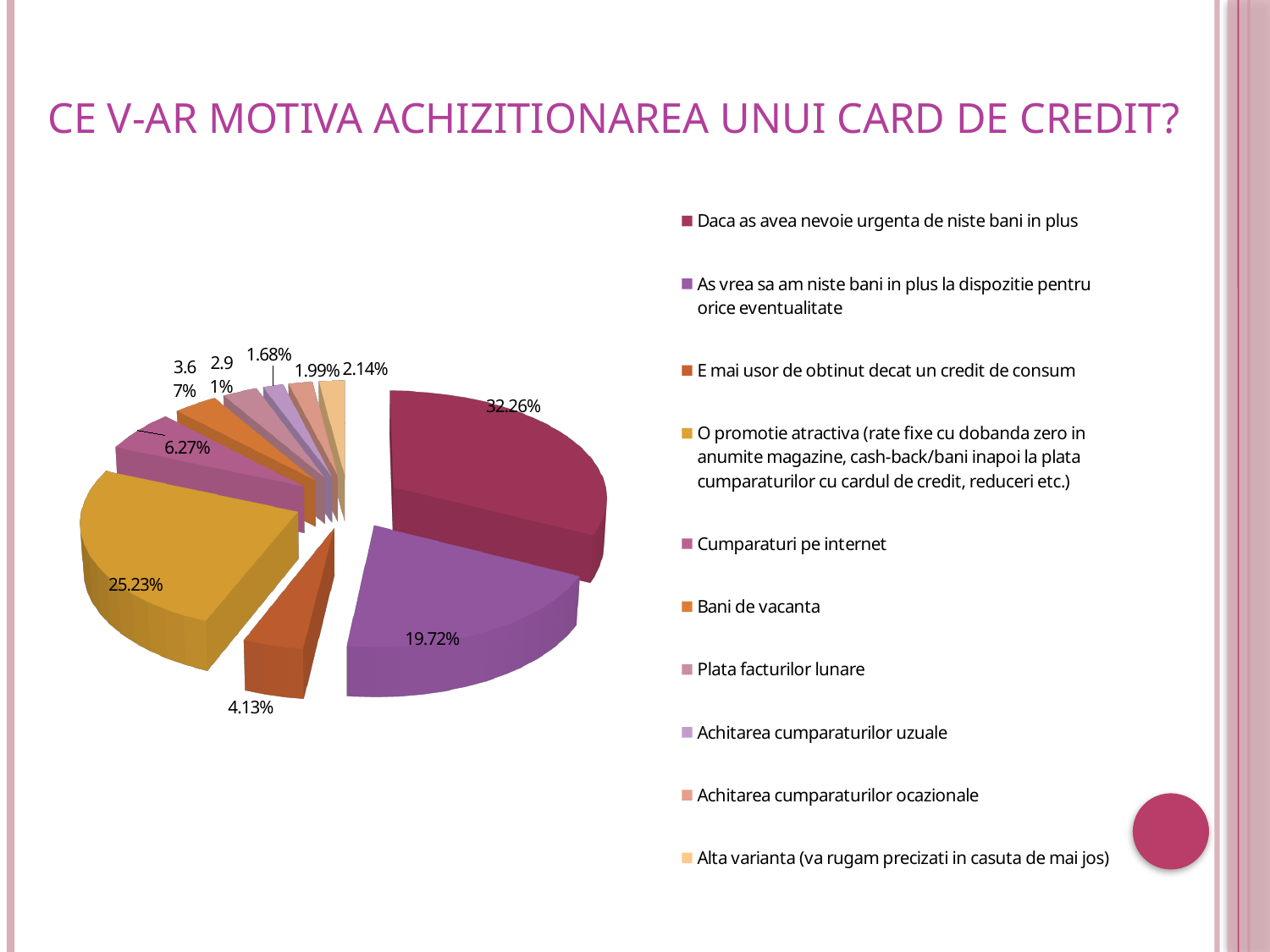
What kind of chart is shown on the slide? Pie chart How many categories does the pie chart's legend list? 10 What is the title of the slide containing the pie chart? CE V-AR MOTIVA ACHIZITIONAREA UNUI CARD DE CREDIT? What share of the pie is labelled for "Daca as avea nevoie urgenta de niste bani in plus"? 32.26% What is the difference in percentage points between the slice for "Daca as avea nevoie urgenta de niste bani in plus" and the slice for "O promotie atractiva"? 7.03 percentage points What percentage is shown for "E mai usor de obtinut decat un credit de consum"? 4.13% What percentage is shown for "O promotie atractiva (rate fixe cu dobanda zero in anumite magazine, cash-back/bani inapoi la plata cumparaturilor cu cardul de credit, reduceri etc.)"? 25.23% Which category has the smallest slice of the pie? Achitarea cumparaturilor uzuale Which slice is larger: "Cumparaturi pe internet" or "E mai usor de obtinut decat un credit de consum"? Cumparaturi pe internet What percentage is shown for "Cumparaturi pe internet"? 6.27% Which category has the largest slice of the pie? Daca as avea nevoie urgenta de niste bani in plus What percentage is shown for "As vrea sa am niste bani in plus la dispozitie pentru orice eventualitate"? 19.72%